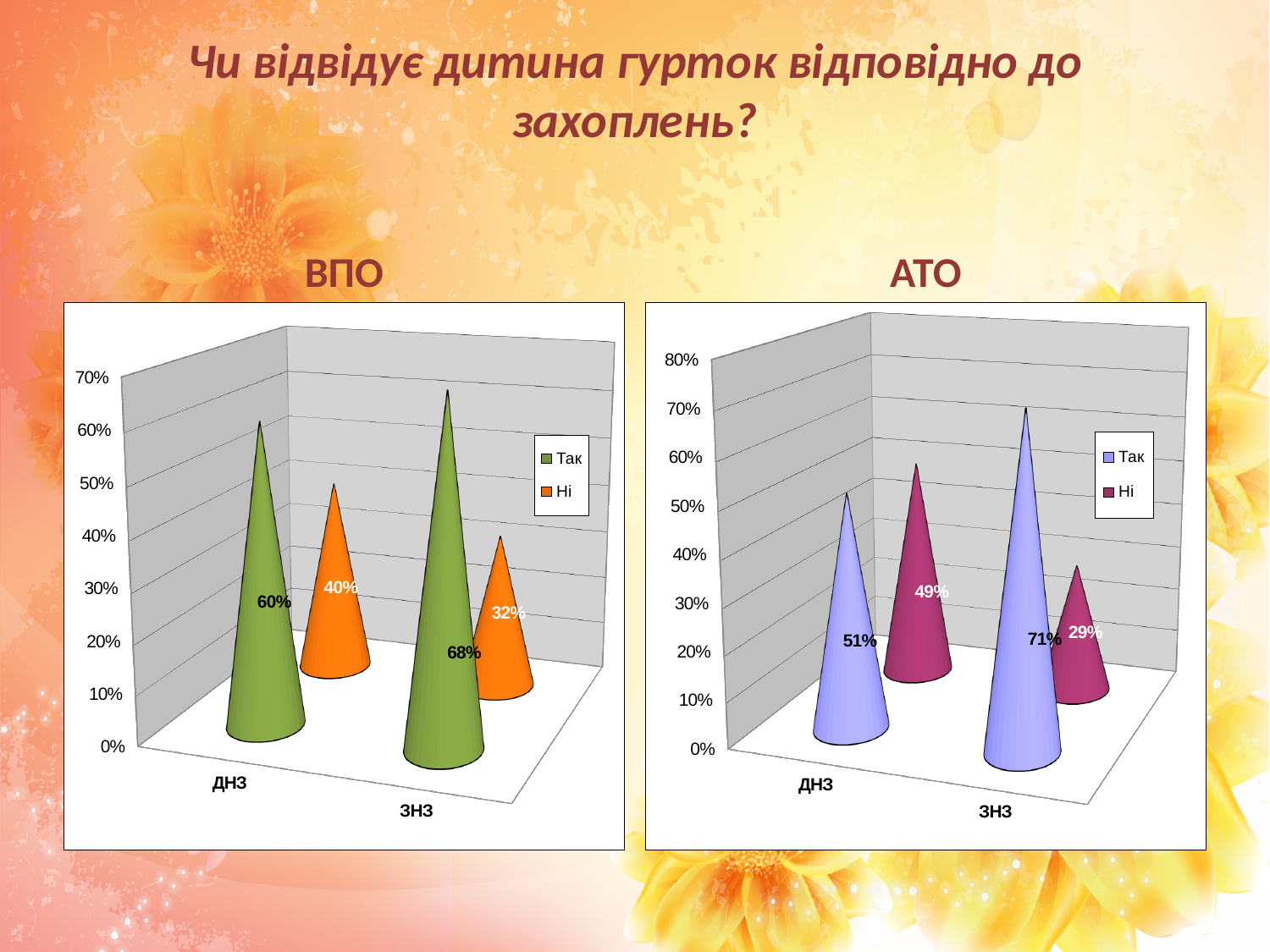
In the ВПО chart, what is the value for Так in the ДНЗ category? 60% In the АТО chart, which category has the lowest Ні value? ЗНЗ In the ВПО chart, what is the value for Ні in the ЗНЗ category? 32% What kind of chart is the ВПО chart? bar chart In the АТО chart, what is the value for Ні in the ДНЗ category? 49% In the ВПО chart, what is the difference between Так and Ні for ЗНЗ? 36% How many categories are shown on the x axis of the АТО chart? 2 In the АТО chart, what is the value for Так in the ЗНЗ category? 71% In the ВПО chart, which category has the highest Так value? ЗНЗ How many series does the legend of the ВПО chart list? 2 In the АТО chart, what is the difference between Так for ЗНЗ and Так for ДНЗ? 20% In the АТО chart, which is larger for ЗНЗ: Так or Ні? Так